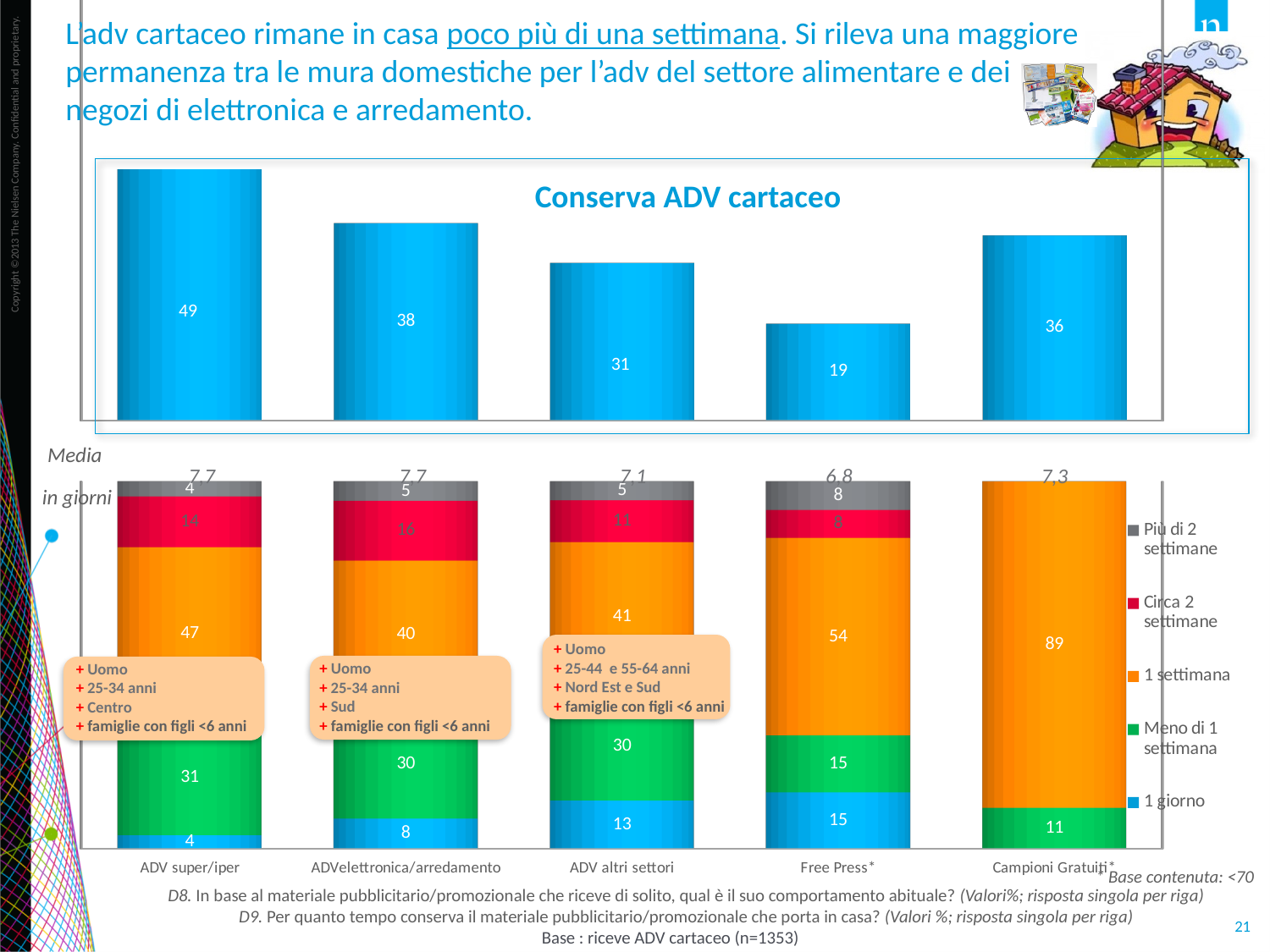
In the bottom stacked chart, what is the value of the 'Meno di 1 settimana' segment for Free Press*? 15 In the top chart 'Conserva ADV cartaceo', how many categories are plotted? 5 In the top chart 'Conserva ADV cartaceo', what is the value for ADV super/iper? 49 In the bottom stacked chart, what is the value of the '1 settimana' segment for Campioni Gratuiti*? 89 In the top chart 'Conserva ADV cartaceo', which category has the highest value? ADV super/iper In the top chart 'Conserva ADV cartaceo', which is larger: ADVelettronica/arredamento or Campioni Gratuiti*? ADVelettronica/arredamento In the top chart 'Conserva ADV cartaceo', what is the difference between ADV super/iper and Free Press*? 30 In the bottom stacked chart, what is the value of the '1 giorno' segment for ADV altri settori? 13 What type of chart is the top chart 'Conserva ADV cartaceo'? Bar chart In the bottom stacked chart, how many series does the legend list? 5 In the bottom stacked chart, which legend entry is shown in orange? 1 settimana In the top chart 'Conserva ADV cartaceo', which category has the lowest value? Free Press*